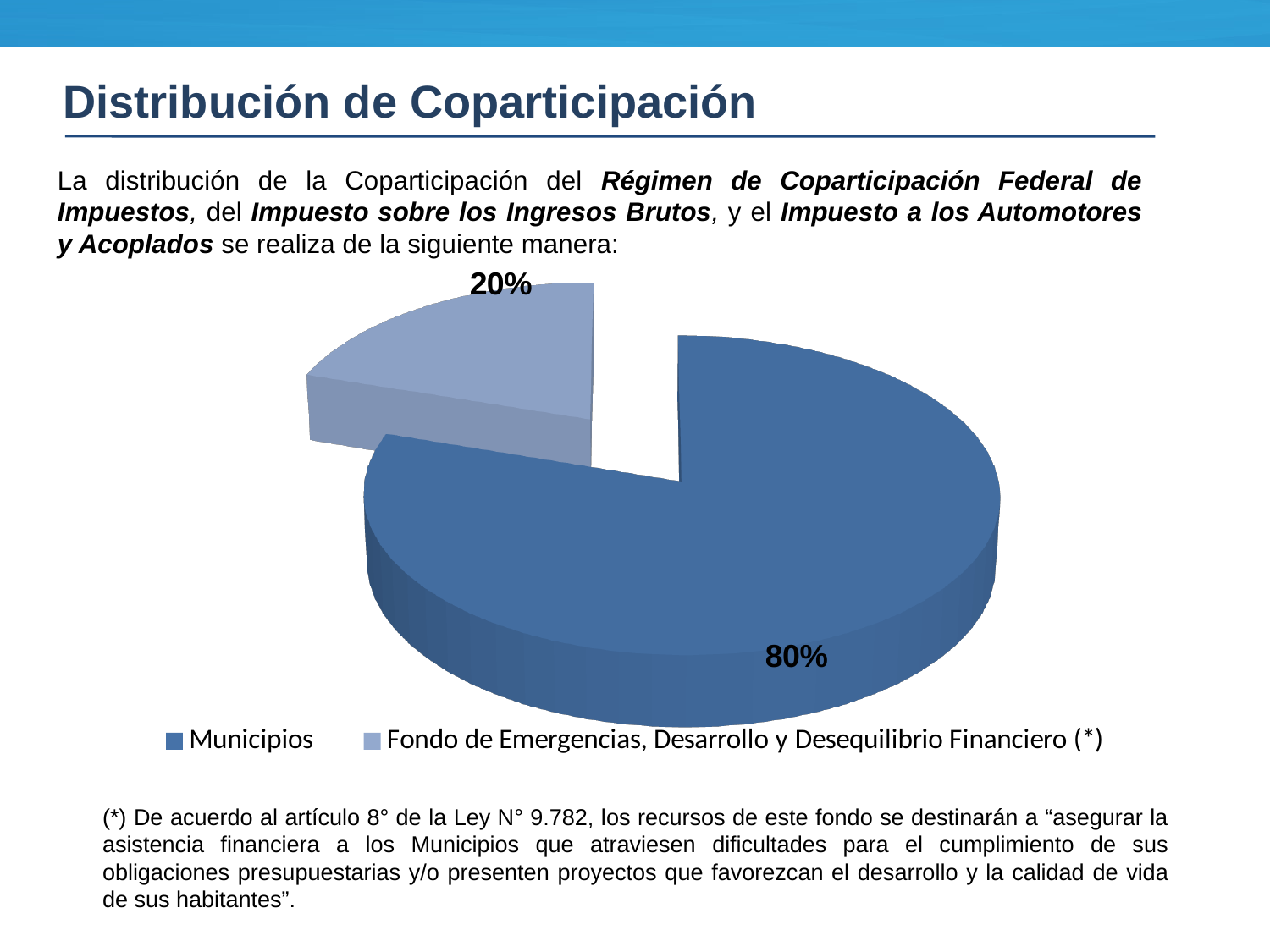
What colour is the Municipios slice in the pie chart? Dark blue How many entries does the legend list? 2 Which slice is pulled out (exploded) from the pie? Fondo de Emergencias, Desarrollo y Desequilibrio Financiero (*) What is the difference in percentage points between the Municipios slice and the Fondo de Emergencias, Desarrollo y Desequilibrio Financiero (*) slice? 60 percentage points What share of the pie does Municipios receive? 80% What kind of chart is shown on the slide? Pie chart Which category has the smallest slice of the pie? Fondo de Emergencias, Desarrollo y Desequilibrio Financiero (*) Which category has the largest slice of the pie? Municipios How many slices does the pie chart have? 2 What share of the pie does Fondo de Emergencias, Desarrollo y Desequilibrio Financiero (*) receive? 20% Which is larger: the share for Municipios or the share for Fondo de Emergencias, Desarrollo y Desequilibrio Financiero (*)? Municipios